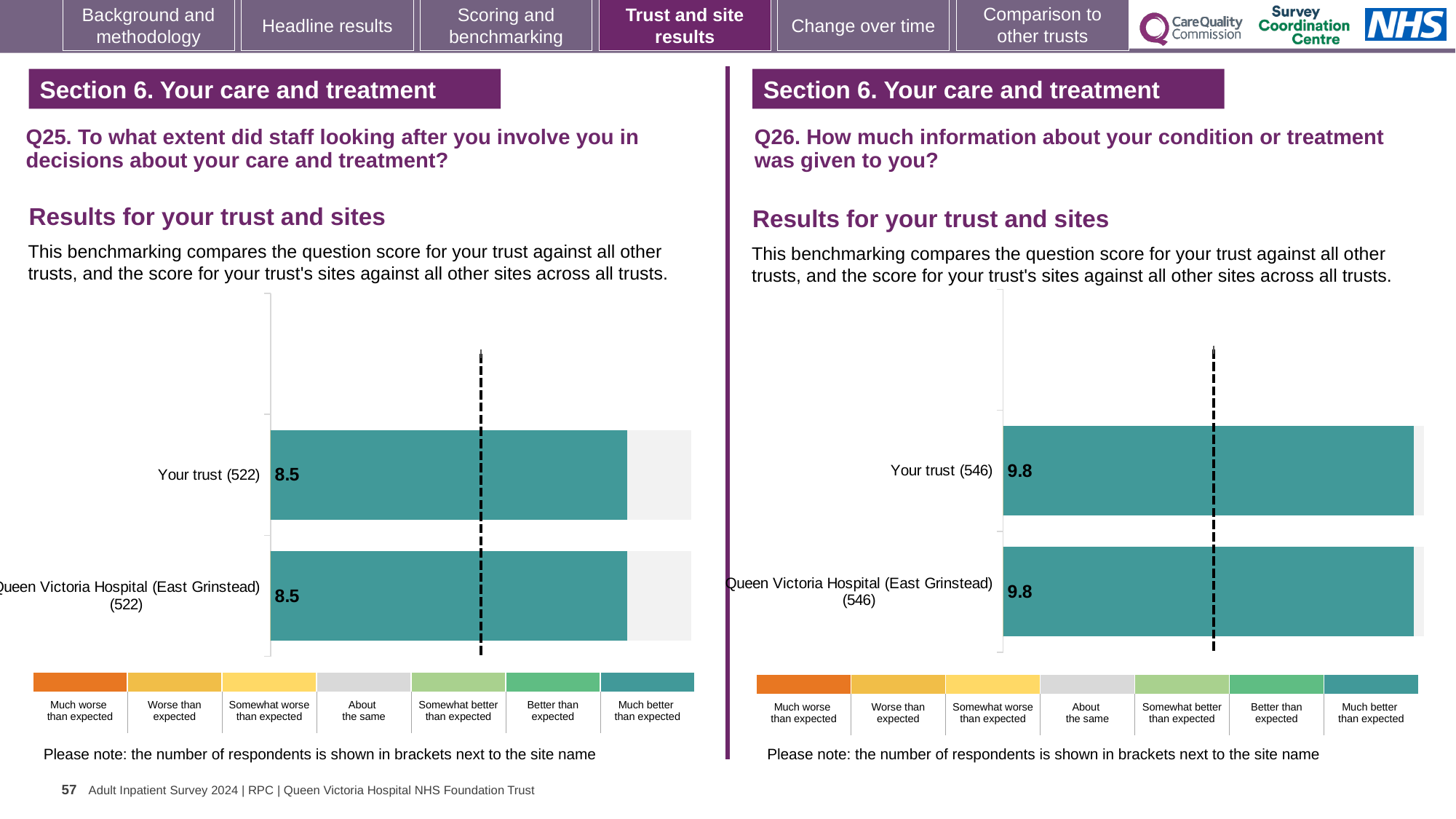
How many bars are plotted in the Q25 chart on the left? 2 In the Q26 chart on the right, how many respondents are shown in brackets for Queen Victoria Hospital (East Grinstead)? 546 In the Q25 chart on the left, what is the score for Your trust? 8.5 How many bars are plotted in the Q26 chart on the right? 2 In the Q26 chart on the right, what is the score for Your trust? 9.8 In the Q25 chart on the left, what is the difference between the score for Your trust and the score for Queen Victoria Hospital (East Grinstead)? 0 In the Q26 chart on the right, what is the score for Queen Victoria Hospital (East Grinstead)? 9.8 In the Q26 chart on the right, what is the difference between the score for Your trust and the score for Queen Victoria Hospital (East Grinstead)? 0 How many benchmark categories does the colour key below the Q26 chart on the right list? 7 In the Q25 chart on the left, how many respondents are shown in brackets for Your trust? 522 What type of chart is used for the Q25 results on the left? Bar chart In the Q25 chart on the left, what is the score for Queen Victoria Hospital (East Grinstead)? 8.5